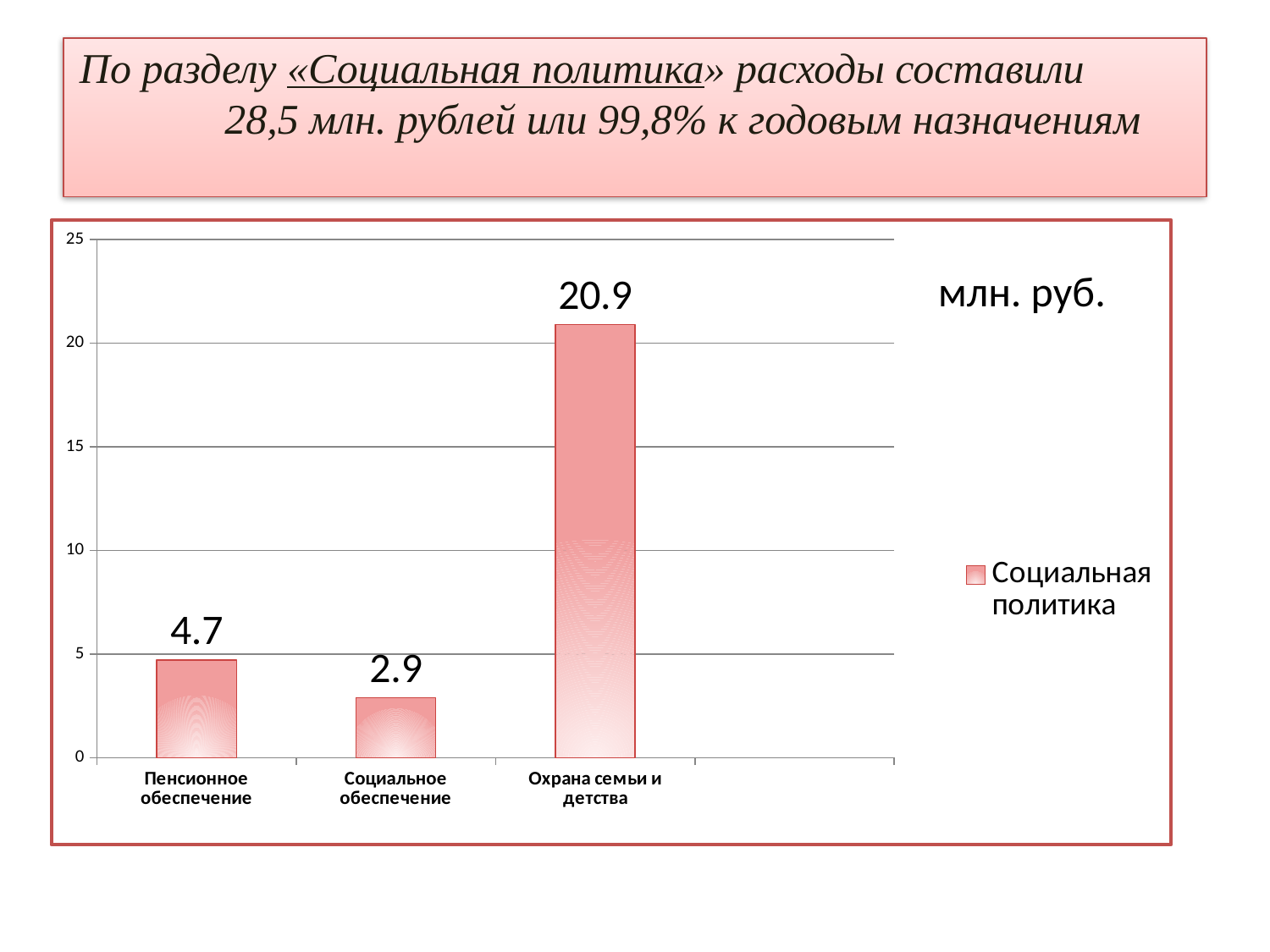
What is the value for Пенсионное обеспечение? 4.7 Which is larger, the value for Пенсионное обеспечение or the value for Социальное обеспечение? Пенсионное обеспечение Which category has the lowest value? Социальное обеспечение What series name does the legend list? Социальная политика What is the difference between the values for Охрана семьи и детства and Пенсионное обеспечение? 16.2 What is the difference between the values for Пенсионное обеспечение and Социальное обеспечение? 1.8 What kind of chart is shown on the slide? bar chart What is the value for Охрана семьи и детства? 20.9 What is the value for Социальное обеспечение? 2.9 Which category has the highest value? Охрана семьи и детства Is the value for Охрана семьи и детства greater or less than 20? greater How many categories are shown on the x axis? 3